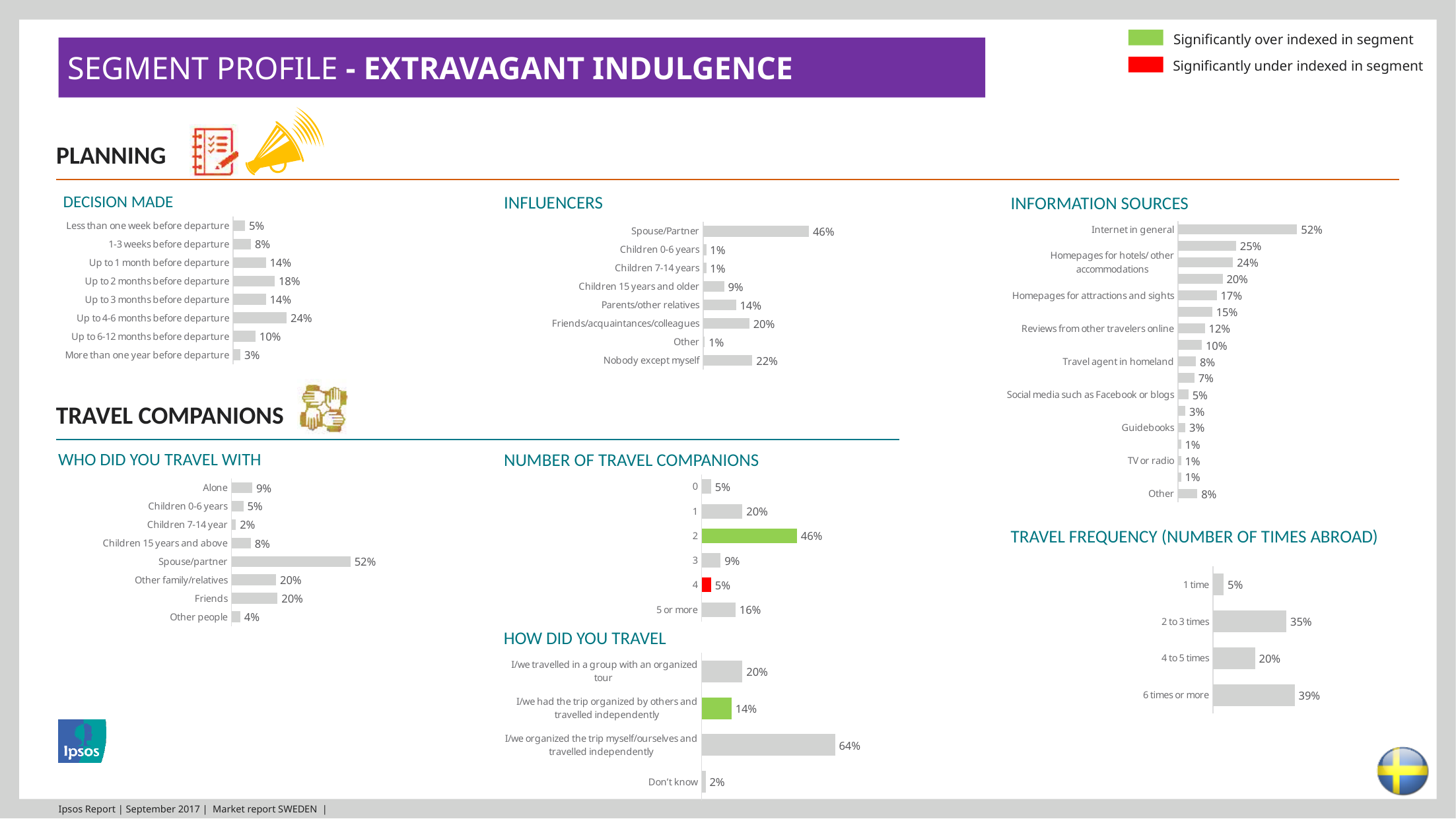
In the "Who did you travel with" chart, which is larger: "Alone" or "Children 15 years and above"? Alone In the "Information sources" chart, what is the difference between "Homepages for attractions and sights" and "Reviews from other travelers online"? 5% In the "Number of travel companions" chart, what is the value for "2"? 46% In the "How did you travel" chart, what is the value for "I/we organized the trip myself/ourselves and travelled independently"? 64% In the "Information sources" chart, what is the value for "Internet in general"? 52% In the "Decision made" chart, which category has the lowest value? More than one year before departure In the "Influencers" chart, what is the value for "Nobody except myself"? 22% In the "Number of travel companions" chart, which bar is coloured red? 4 In the "Travel frequency (number of times abroad)" chart, what is the difference between "6 times or more" and "2 to 3 times"? 4% In the "Who did you travel with" chart, how many categories are shown? 8 In the "Decision made" chart, what is the value for "Up to 4-6 months before departure"? 24% In the "Influencers" chart, which category has the highest value? Spouse/Partner